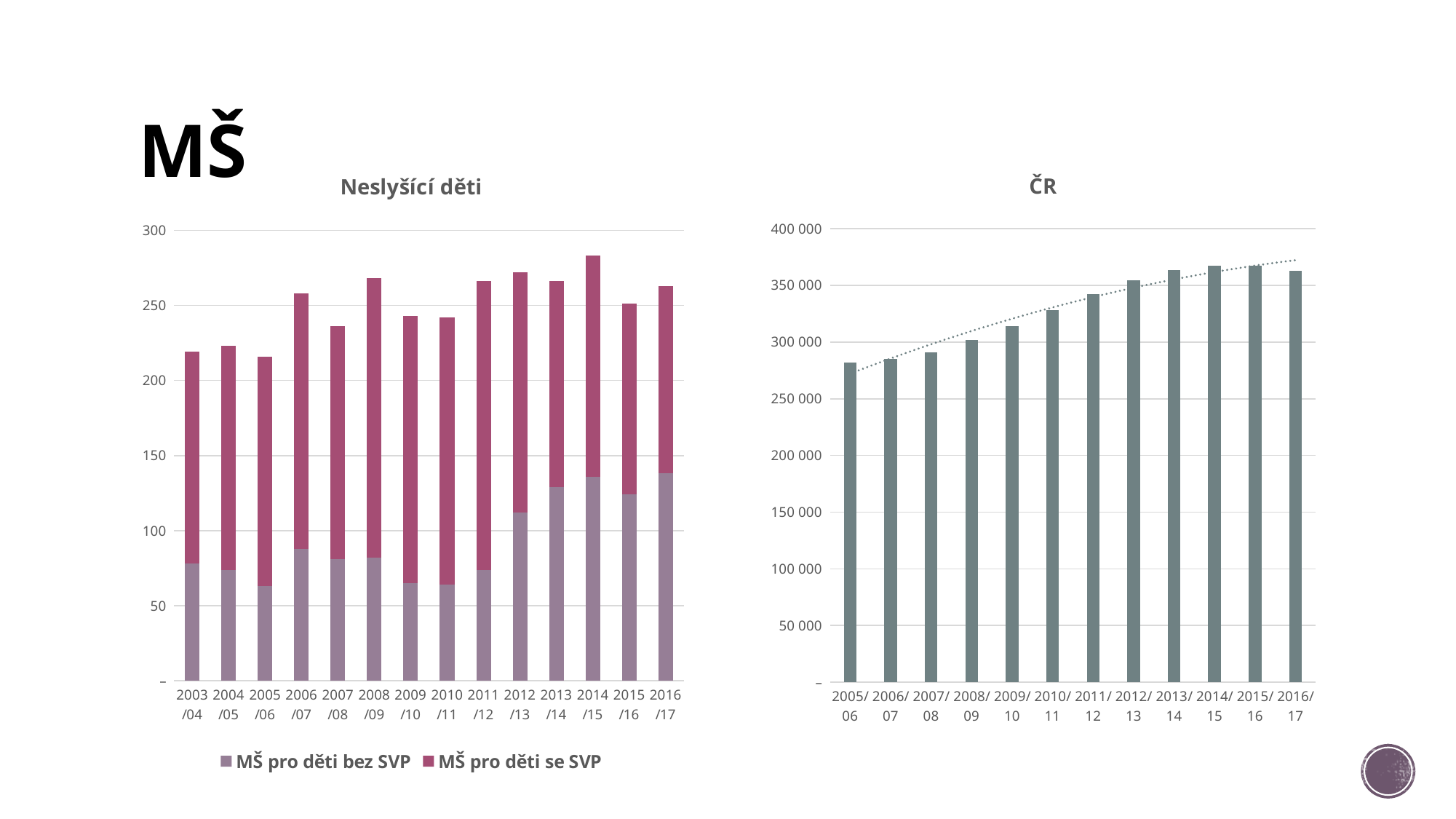
In the "ČR" chart, is the value for 2005/06 greater or less than 300 000? less In the "ČR" chart, which school year has the lowest value? 2005/06 In the "Neslyšící děti" chart, which series is shown in the darker red colour? MŠ pro děti se SVP In the "ČR" chart, is the value for 2016/17 greater or less than 350 000? greater How many school years are shown on the x axis of the "Neslyšící děti" chart? 14 What kind of chart is the "Neslyšící děti" chart? bar chart In the "Neslyšící děti" chart, is the total for 2005/06 greater or less than 250? less How many school years are shown on the x axis of the "ČR" chart? 12 In the "ČR" chart, do the values generally rise or fall from 2005/06 to 2016/17? rise In the "Neslyšící děti" chart, which school year has the highest total bar? 2014/15 How many series does the legend of the "Neslyšící děti" chart list? 2